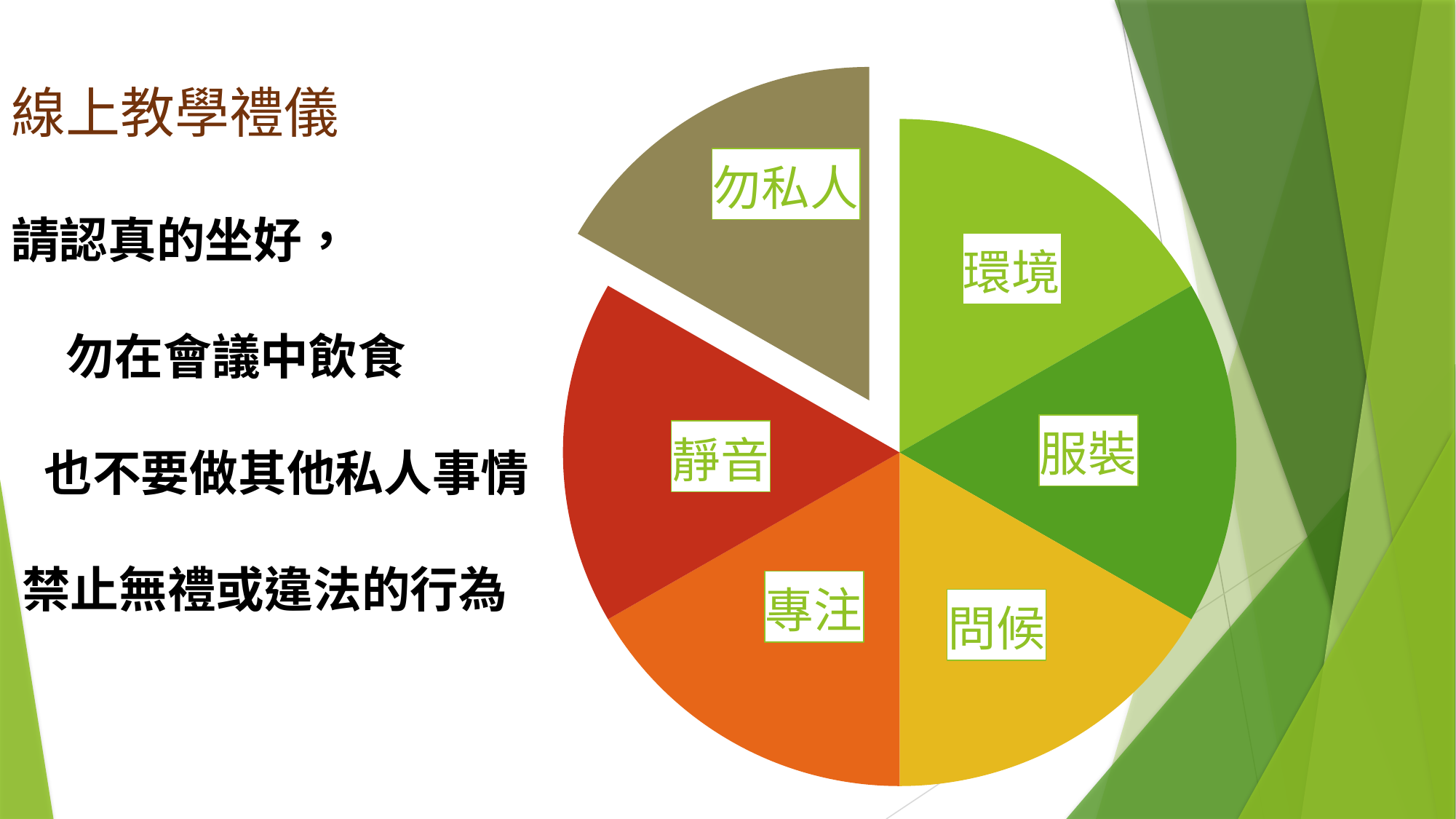
How many slices does the pie chart have? 6 Do the slices of the pie chart appear to be equal in size? yes What colour is the slice labelled 靜音 in the pie chart? red What kind of chart is shown on the slide? pie chart Which slice of the pie chart is pulled out (exploded) from the rest of the pie? 勿私人